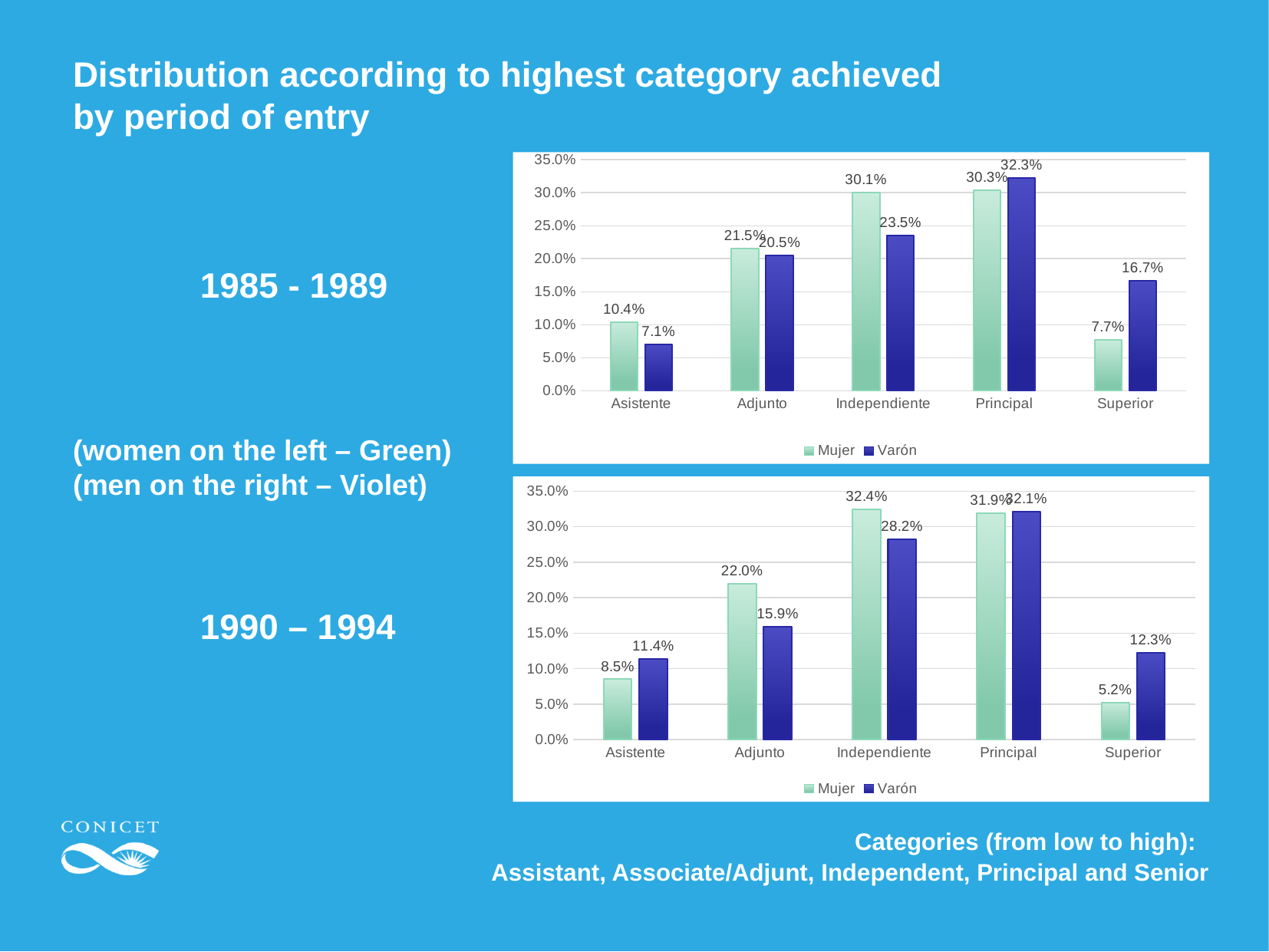
In the bottom chart (1990 – 1994), which category has the lowest value for Mujer? Superior How many categories are shown on the x axis of the top chart (1985 - 1989)? 5 In the top chart (1985 - 1989), what is the value for Mujer in the Independiente category? 30.1% In the bottom chart (1990 – 1994), what is the difference between the Varón and Mujer values for Superior? 7.1% How many series does the legend of the bottom chart (1990 – 1994) list? 2 In the bottom chart (1990 – 1994), which is larger for Adjunto: the Mujer value or the Varón value? Mujer What type of chart is the top chart (1985 - 1989)? Bar chart In the bottom chart (1990 – 1994), what is the value for Mujer in the Adjunto category? 22.0% In the top chart (1985 - 1989), what is the value for Varón in the Superior category? 16.7% In the top chart (1985 - 1989), what is the difference between the Mujer and Varón values for Independiente? 6.6% In the bottom chart (1990 – 1994), what is the value for Varón in the Asistente category? 11.4% In the top chart (1985 - 1989), which category has the highest value for Varón? Principal